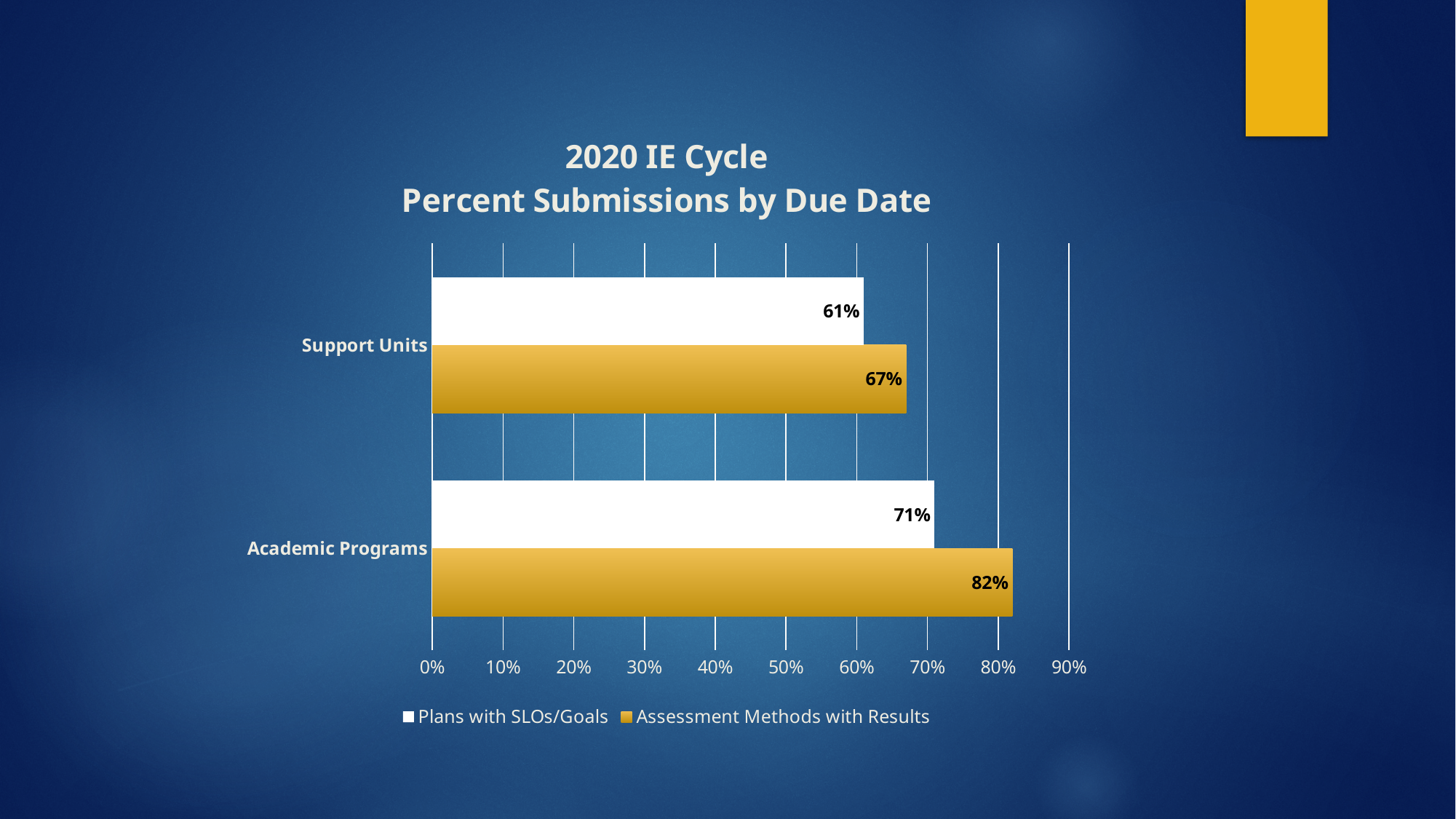
What is the difference between Assessment Methods with Results and Plans with SLOs/Goals for Academic Programs? 11% What is the value for Assessment Methods with Results for Academic Programs? 82% How many series does the legend list? 2 Which category has the highest value for Assessment Methods with Results? Academic Programs What is the value for Assessment Methods with Results for Support Units? 67% Which is larger for Support Units: Plans with SLOs/Goals or Assessment Methods with Results? Assessment Methods with Results What is the difference in Plans with SLOs/Goals between Academic Programs and Support Units? 10% What is the value for Plans with SLOs/Goals for Support Units? 61% Which category has the lowest value for Plans with SLOs/Goals? Support Units What is the value for Plans with SLOs/Goals for Academic Programs? 71% How many categories are shown on the chart? 2 What kind of chart is shown on the slide? Bar chart